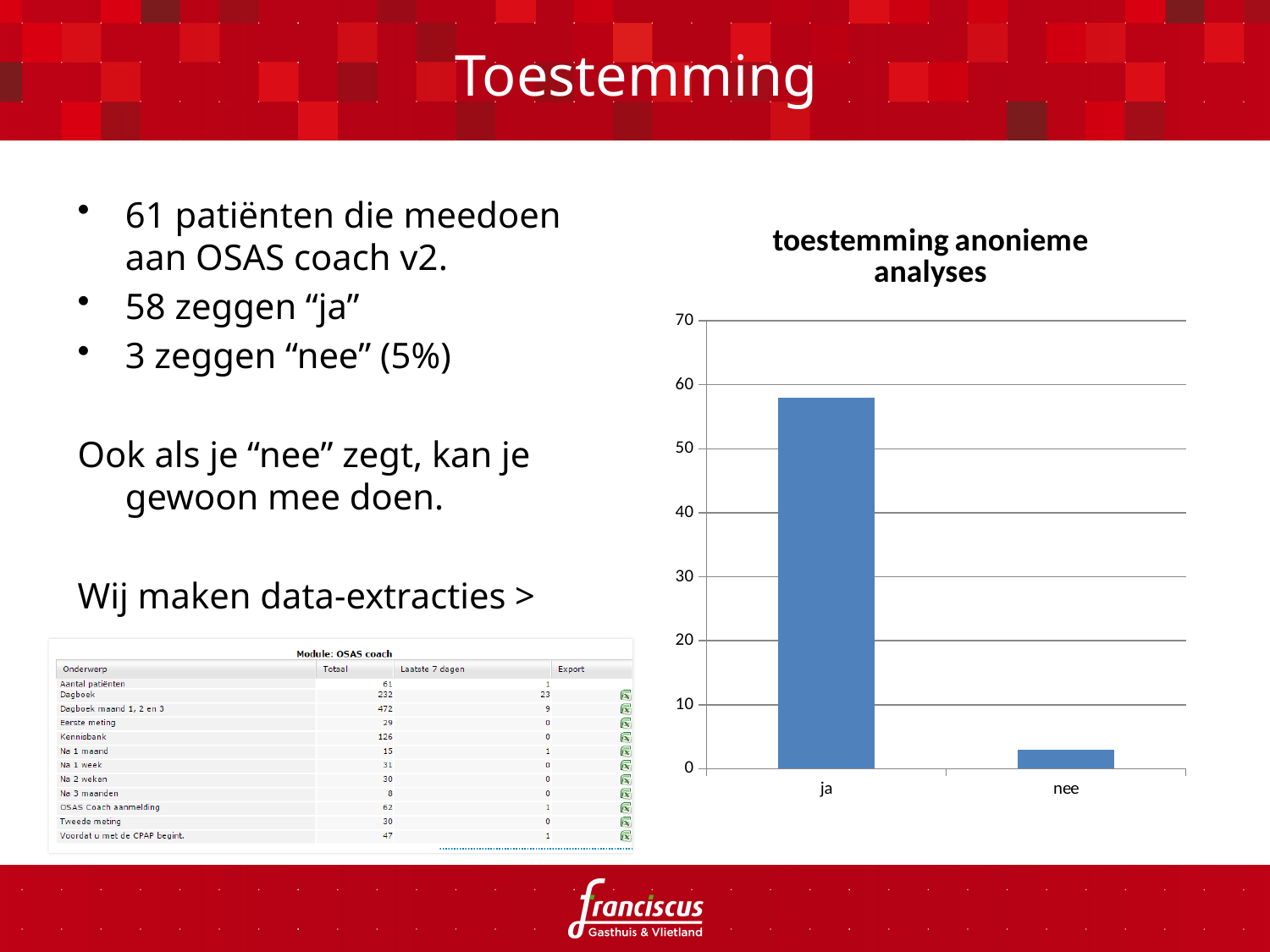
Which category has the lowest bar in the "toestemming anonieme analyses" chart? nee In the "toestemming anonieme analyses" chart, is the value for "nee" greater or less than 10? less What is the title of the bar chart on the right side of the slide? toestemming anonieme analyses In the "toestemming anonieme analyses" chart, is the value for "ja" greater or less than 50? greater In the "toestemming anonieme analyses" chart, is the value for "ja" greater or less than 60? less What is the highest tick value shown on the y axis of the "toestemming anonieme analyses" chart? 70 In the "toestemming anonieme analyses" chart, which is larger, the bar for "ja" or the bar for "nee"? ja Which category has the highest bar in the "toestemming anonieme analyses" chart? ja What kind of chart is shown under the title "toestemming anonieme analyses"? bar chart How many categories are shown on the x axis of the "toestemming anonieme analyses" chart? 2